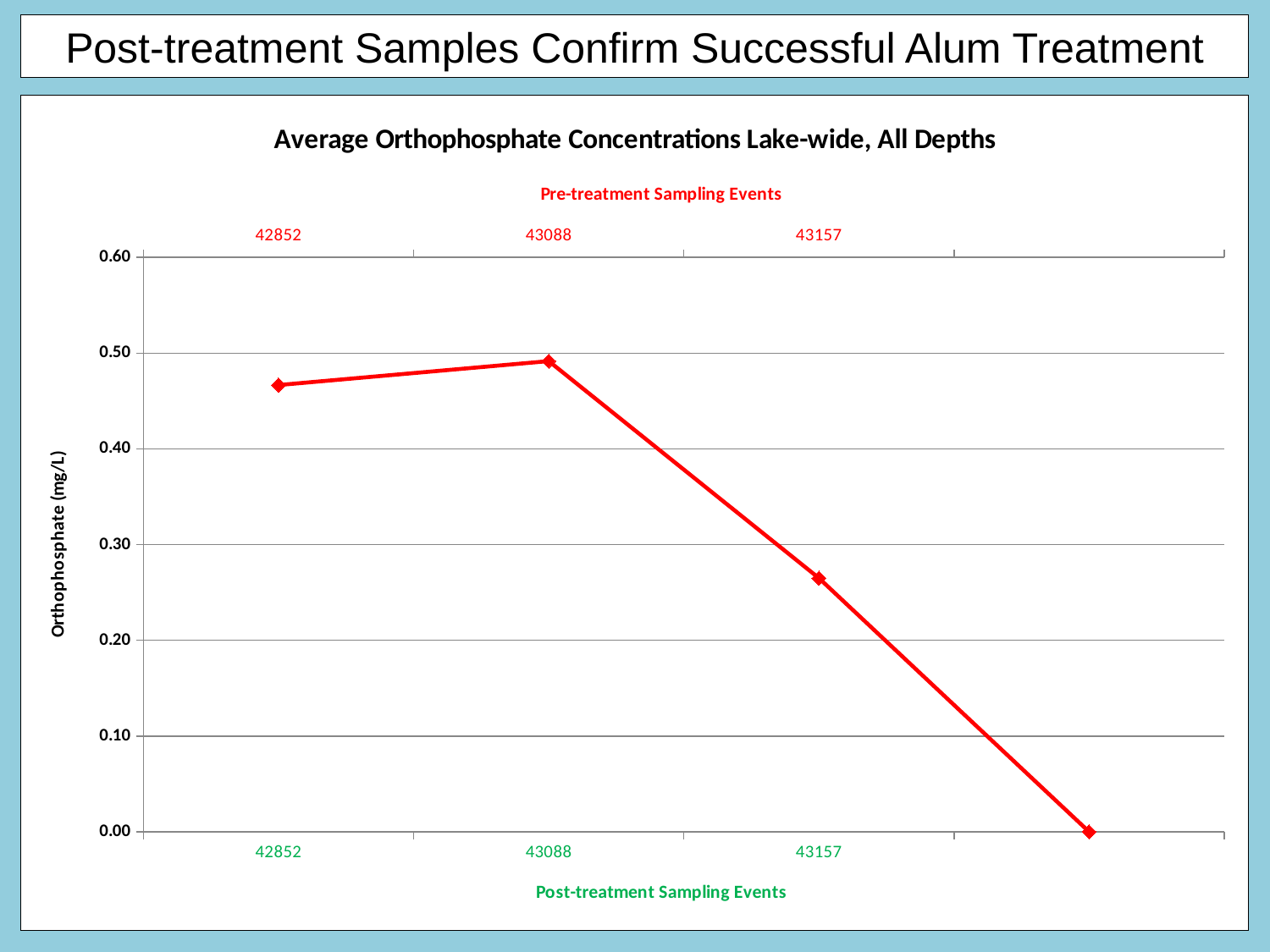
How many data points are plotted on the line? 4 What kind of chart is shown on the slide? Line chart Which has the larger orthophosphate concentration, sampling event 42852 or 43157? 42852 Is the value for sampling event 43157 greater or less than 0.30? less What is the title of the chart? Average Orthophosphate Concentrations Lake-wide, All Depths Is the value for sampling event 42852 greater or less than 0.40? greater Which labelled sampling event has the highest orthophosphate concentration? 43088 What value does the rightmost point on the line reach on the y axis? 0.00 Which has the larger orthophosphate concentration, sampling event 42852 or 43088? 43088 Is the value for sampling event 43088 greater or less than 0.40? greater What is the label on the vertical axis? Orthophosphate (mg/L) Do the values rise or fall along the x axis after sampling event 43088? fall